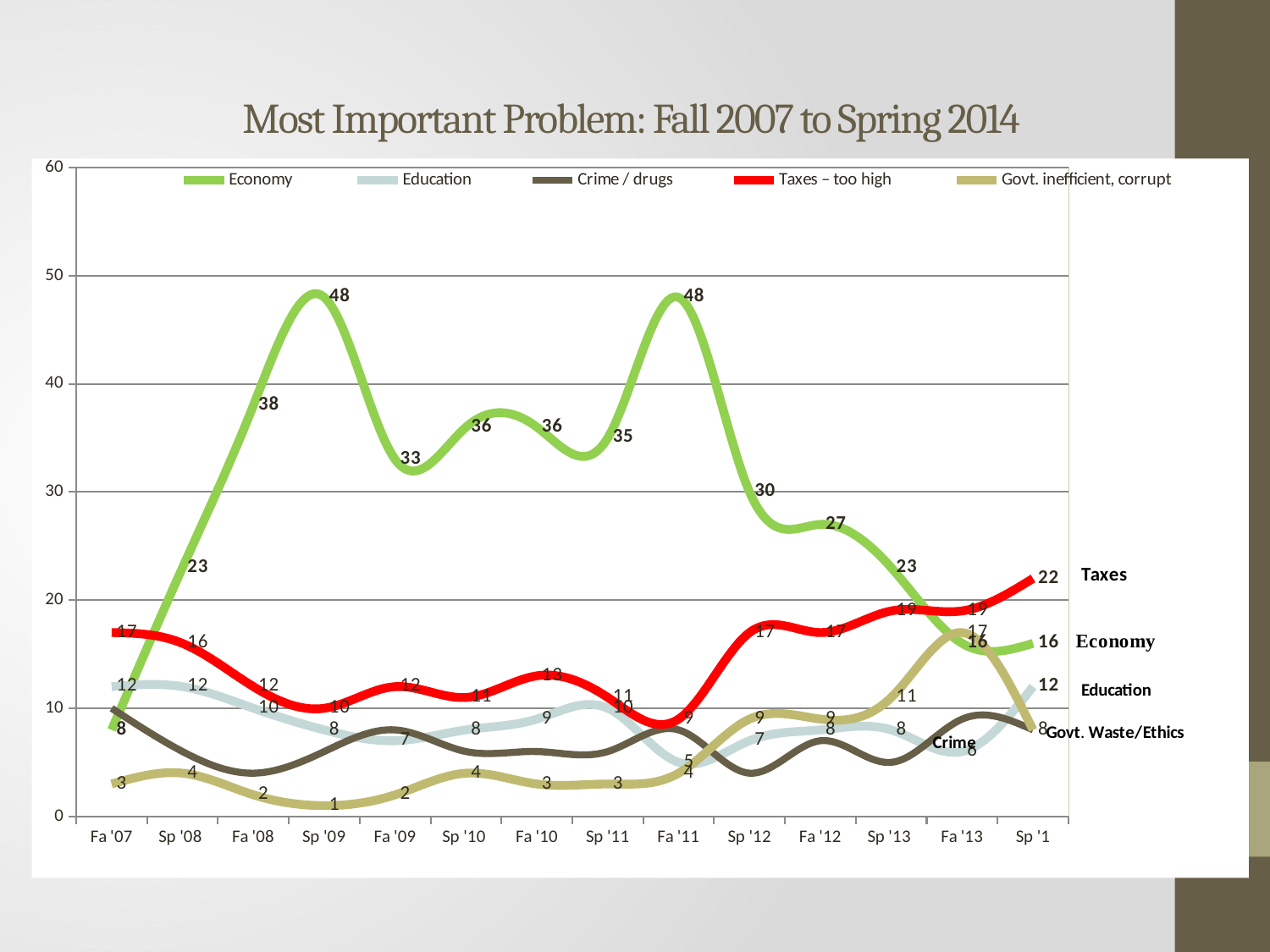
Does the Economy series rise or fall from Fa '11 to Sp '14? Fall What is the value for Economy at Sp '09? 48 What is the value for Taxes – too high at Sp '14 (the last point)? 22 What is the lowest value of the Govt. inefficient, corrupt series? 1 What is the highest value reached by the Economy series? 48 At the last point (Sp '14), which is larger: Taxes – too high or Economy? Taxes – too high What is the difference between the Economy value at Sp '09 and its value at the last point, Sp '14? 32 What type of chart is shown on the slide? Line chart How many series does the legend list? 5 What is the value for Govt. inefficient, corrupt at Fa '13? 17 What is the title of the chart? Most Important Problem: Fall 2007 to Spring 2014 How many time points are shown along the x axis? 14